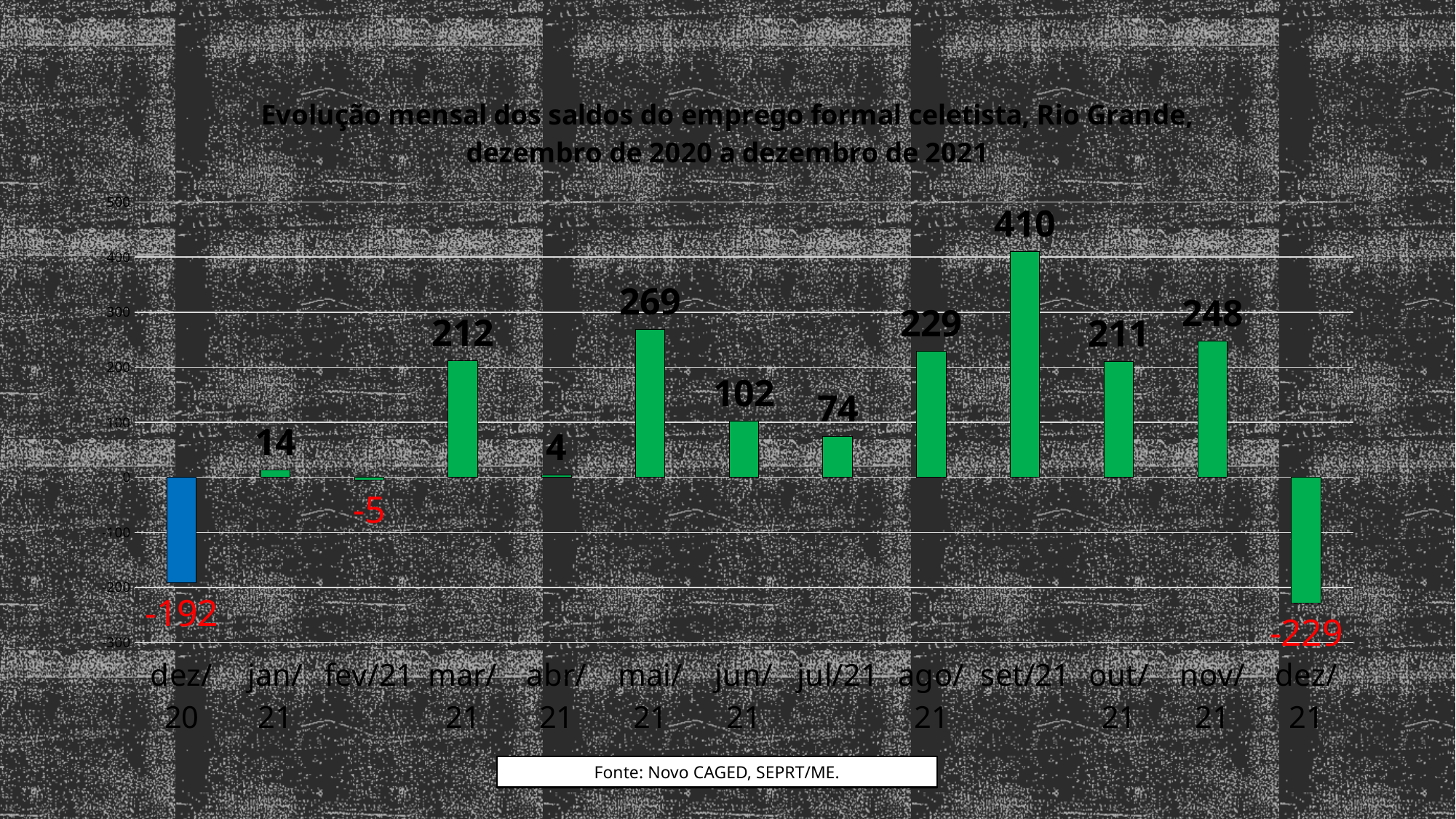
Which bar is coloured blue rather than green? dez/20 How many months are shown on the x axis? 13 What is the value for set/21? 410 Do the values rise or fall from jun/21 to jul/21? fall What is the difference between the values for set/21 and mai/21? 141 What is the value for dez/20? -192 Which month has the highest value? set/21 What kind of chart is this? bar chart What is the value for jul/21? 74 Which is larger, the value for ago/21 or the value for mar/21? ago/21 Which month has the lowest value? dez/21 What is the difference between the values for nov/21 and out/21? 37